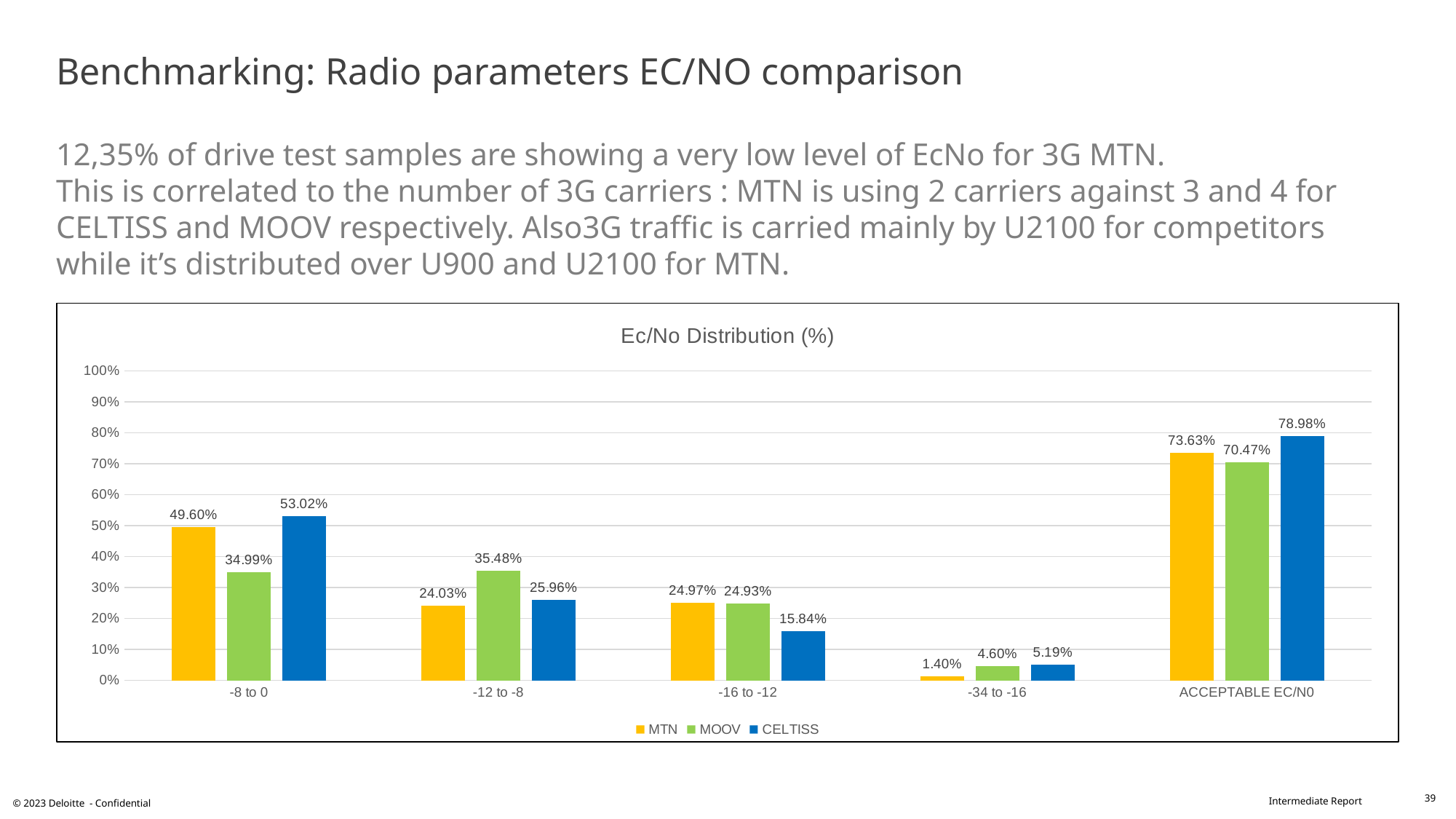
What is the value for MTN in the -8 to 0 category? 49.60% What is the value for CELTISS in the ACCEPTABLE EC/N0 category? 78.98% Which series has the highest value in the -8 to 0 category? CELTISS Is the value for MOOV in the ACCEPTABLE EC/N0 category greater or less than 60%? greater How many series does the legend list? 3 What kind of chart is shown on the slide? Bar chart What is the difference between the CELTISS and MTN values in the ACCEPTABLE EC/N0 category? 5.35% What is the value for MOOV in the -12 to -8 category? 35.48% Which series has the lowest value in the -34 to -16 category? MTN What is the title of the chart? Ec/No Distribution (%) How many categories are shown on the x axis? 5 Which is larger in the -16 to -12 category: the MOOV value or the CELTISS value? MOOV